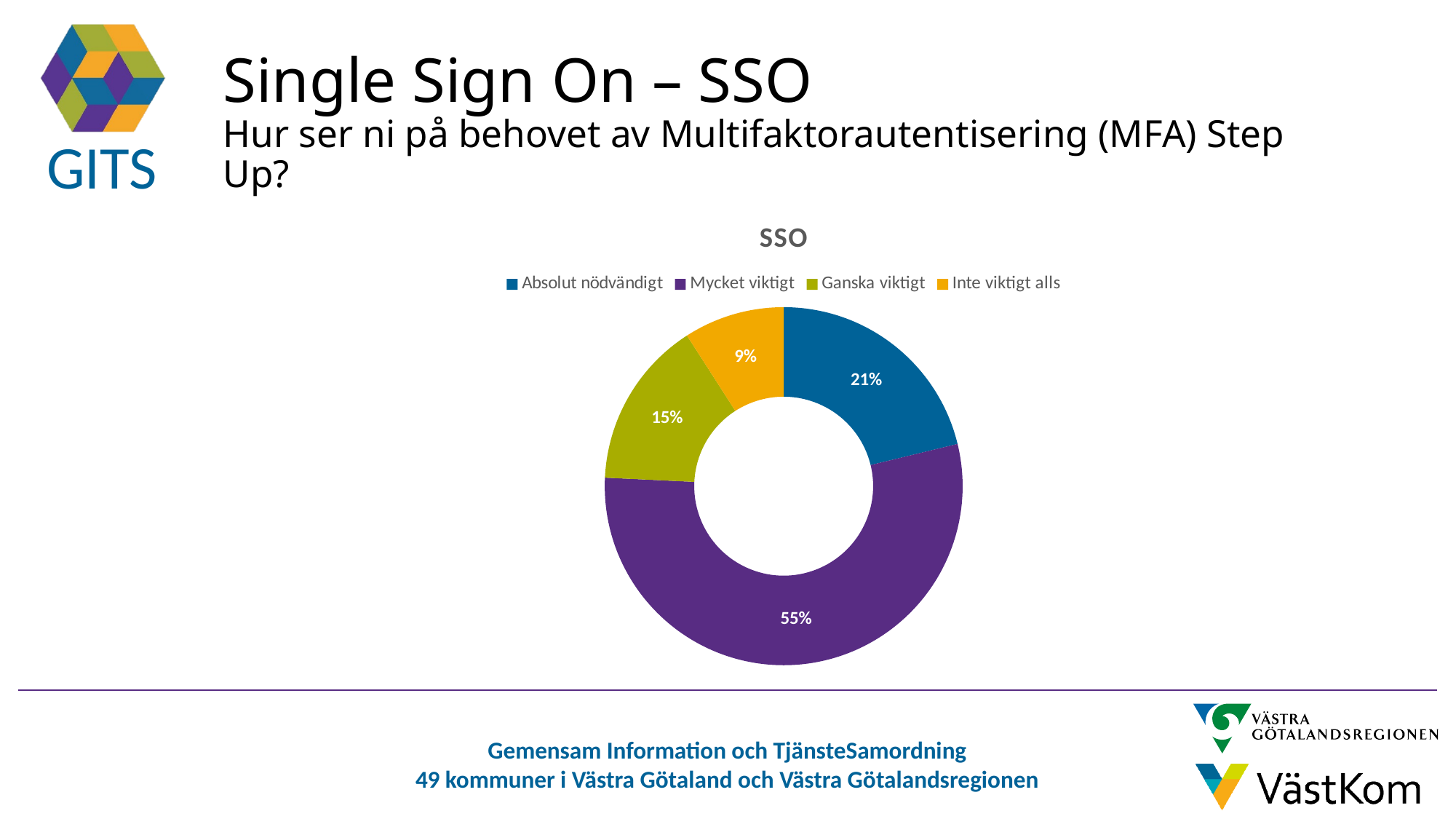
What share of the SSO chart is labelled "Ganska viktigt"? 15% What is the difference in percentage points between "Mycket viktigt" and "Absolut nödvändigt" in the SSO chart? 34 What is the title of the chart on the slide? SSO How many categories are shown in the SSO chart? 4 Which category has the largest share in the SSO chart? Mycket viktigt Which is larger in the SSO chart: "Ganska viktigt" or "Inte viktigt alls"? Ganska viktigt What share of the SSO chart is labelled "Mycket viktigt"? 55% What share of the SSO chart is labelled "Absolut nödvändigt"? 21% What kind of chart is the SSO chart? Doughnut (pie) chart Which category has the smallest share in the SSO chart? Inte viktigt alls What share of the SSO chart is labelled "Inte viktigt alls"? 9% What colour is the "Ganska viktigt" slice in the SSO chart? Green